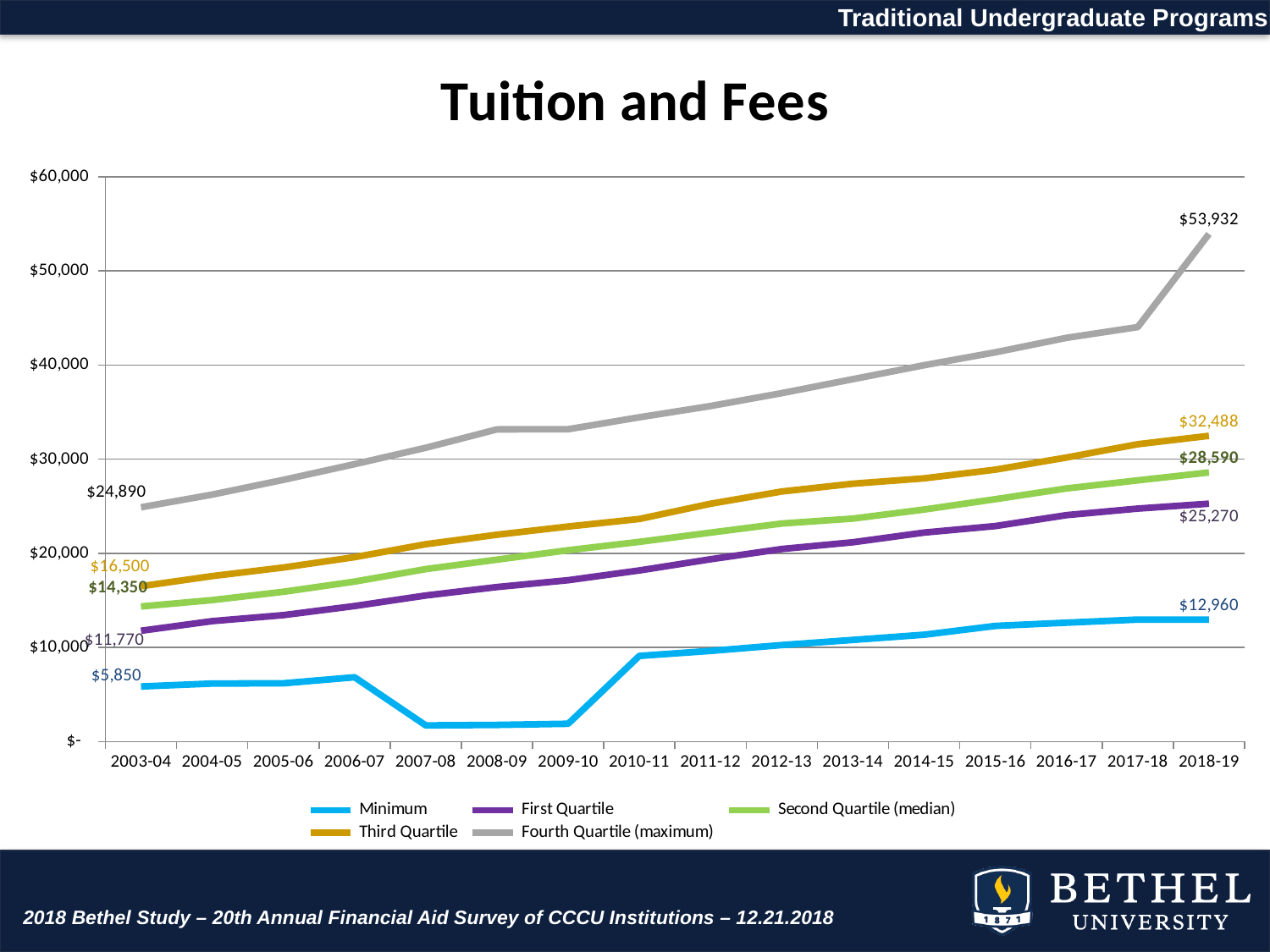
What is the value of the Second Quartile (median) series in 2018-19? $28,590 Which series has the highest value in 2018-19? Fourth Quartile (maximum) What is the value of the Third Quartile series in 2018-19? $32,488 How many series does the legend list? 5 How many academic years are shown on the x axis? 16 What is the value of the Fourth Quartile (maximum) series in 2018-19? $53,932 What is the value of the Minimum series in 2003-04? $5,850 What is the difference between the Third Quartile and First Quartile values in 2018-19? $7,218 Is the Fourth Quartile (maximum) value in 2017-18 greater or less than $40,000? greater How much did the Fourth Quartile (maximum) value increase from 2003-04 to 2018-19? $29,042 What is the value of the First Quartile series in 2003-04? $11,770 What type of chart is shown on the slide? Line chart